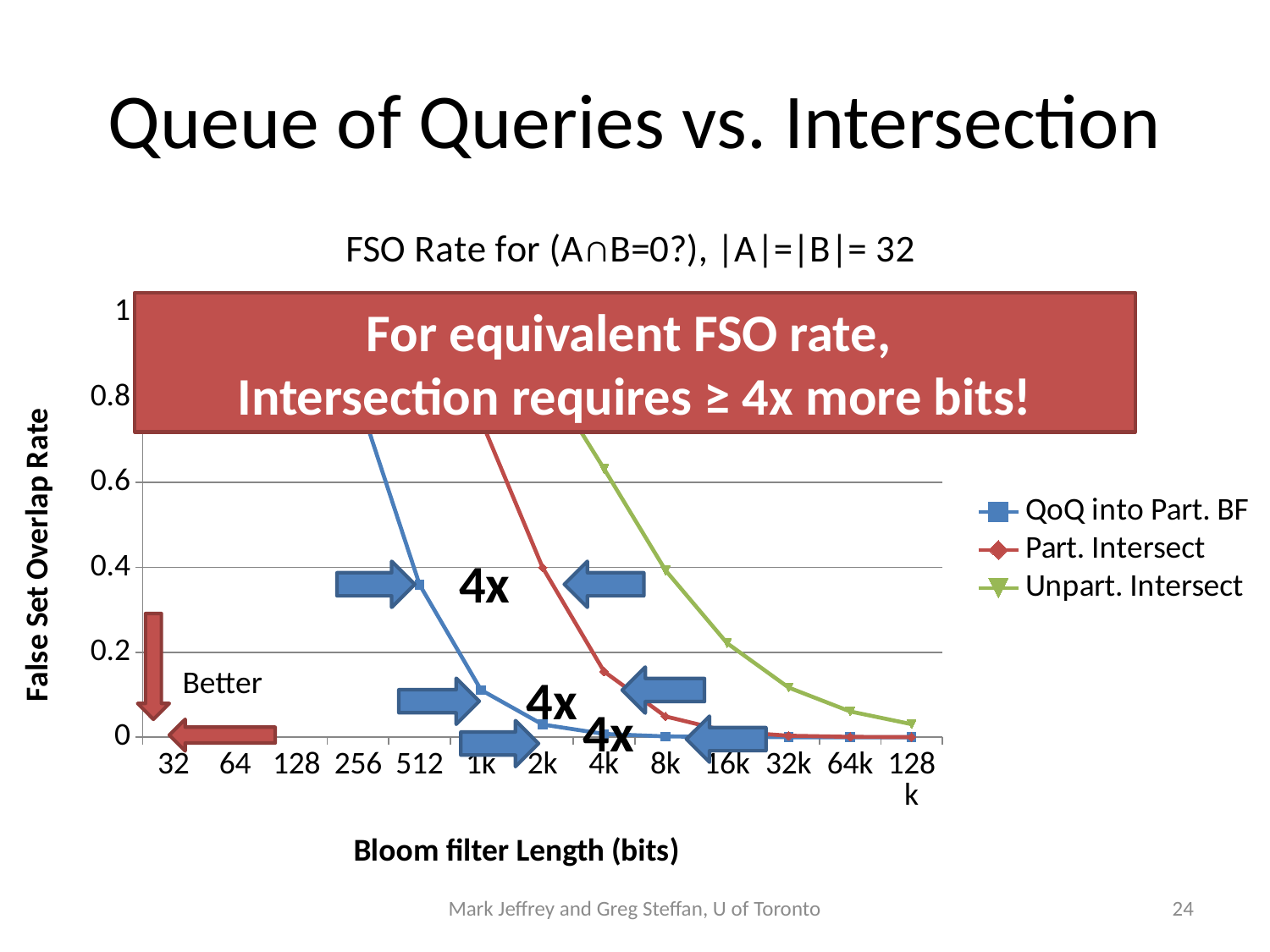
What kind of chart is shown on the slide? line chart Is the False Set Overlap Rate for Unpart. Intersect at 4k bits greater or less than 0.4? greater Is the False Set Overlap Rate for QoQ into Part. BF at 1k bits greater or less than 0.2? less Is the False Set Overlap Rate for Unpart. Intersect at 32k bits greater or less than 0.2? less What is the title of the x axis of the chart? Bloom filter Length (bits) At 1k bits, which series has the higher False Set Overlap Rate, QoQ into Part. BF or Part. Intersect? Part. Intersect How many series does the chart legend list? 3 As Bloom filter length increases, do the False Set Overlap Rate values rise or fall? fall At 4k bits, which series has the higher False Set Overlap Rate, Part. Intersect or Unpart. Intersect? Unpart. Intersect How many Bloom filter length values are marked along the x axis? 13